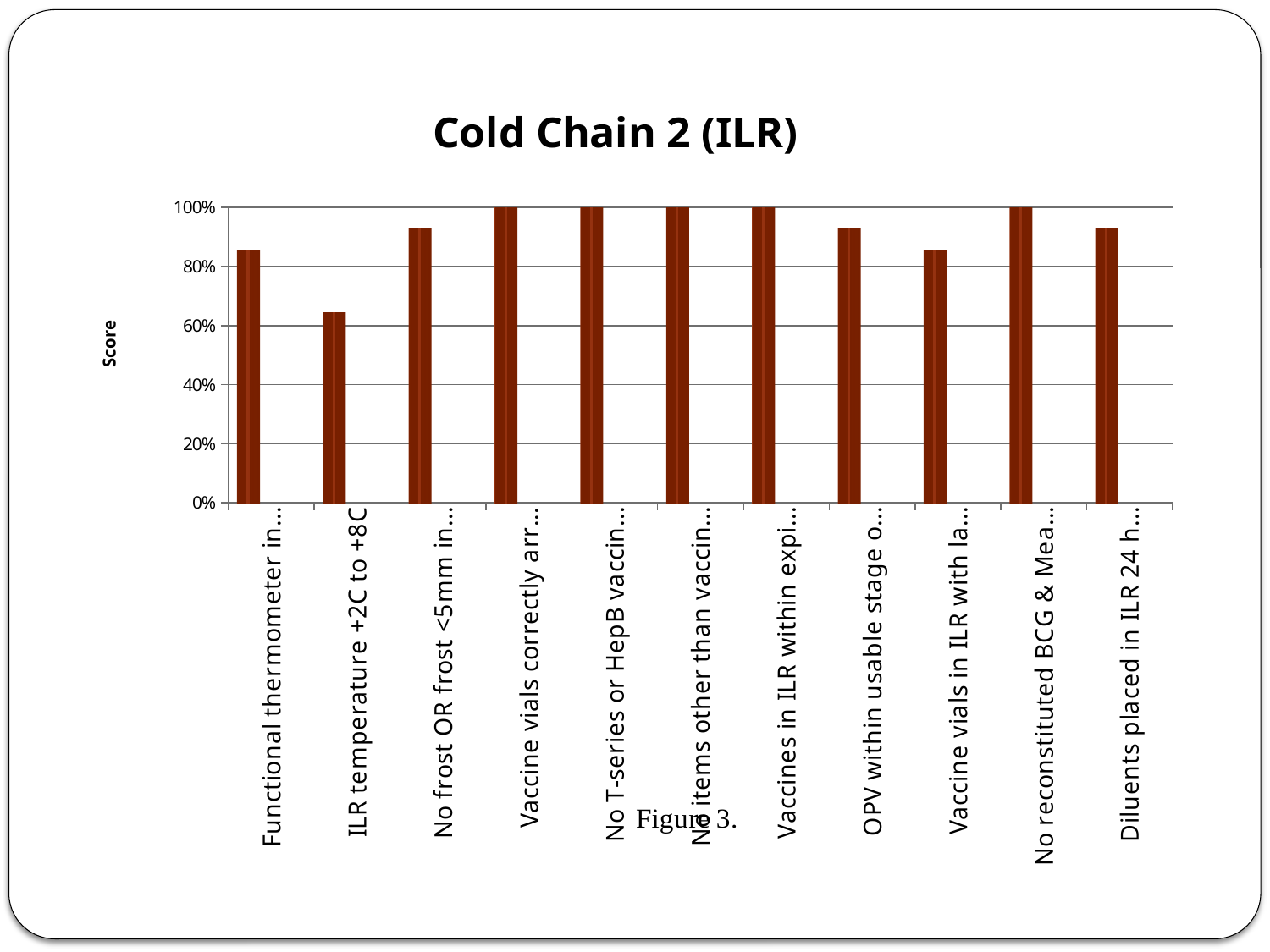
What is the score for 'No reconstituted BCG & Mea...'? 100% Is the score for 'ILR temperature +2C to +8C' greater or less than 60%? greater What is the title of the chart? Cold Chain 2 (ILR) Which category has the lowest score in the Cold Chain 2 (ILR) chart? ILR temperature +2C to +8C What kind of chart is shown on the slide? bar chart How many categories (bars) are plotted in the Cold Chain 2 (ILR) chart? 11 What is the score for 'Vaccine vials correctly arr...'? 100% What is the label on the vertical axis of the chart? Score Is the score for 'Functional thermometer in...' greater or less than 80%? greater How many bars in the chart reach 100%? 5 Is the score for 'ILR temperature +2C to +8C' greater or less than 80%? less Which has the higher score: 'Functional thermometer in...' or 'ILR temperature +2C to +8C'? Functional thermometer in...